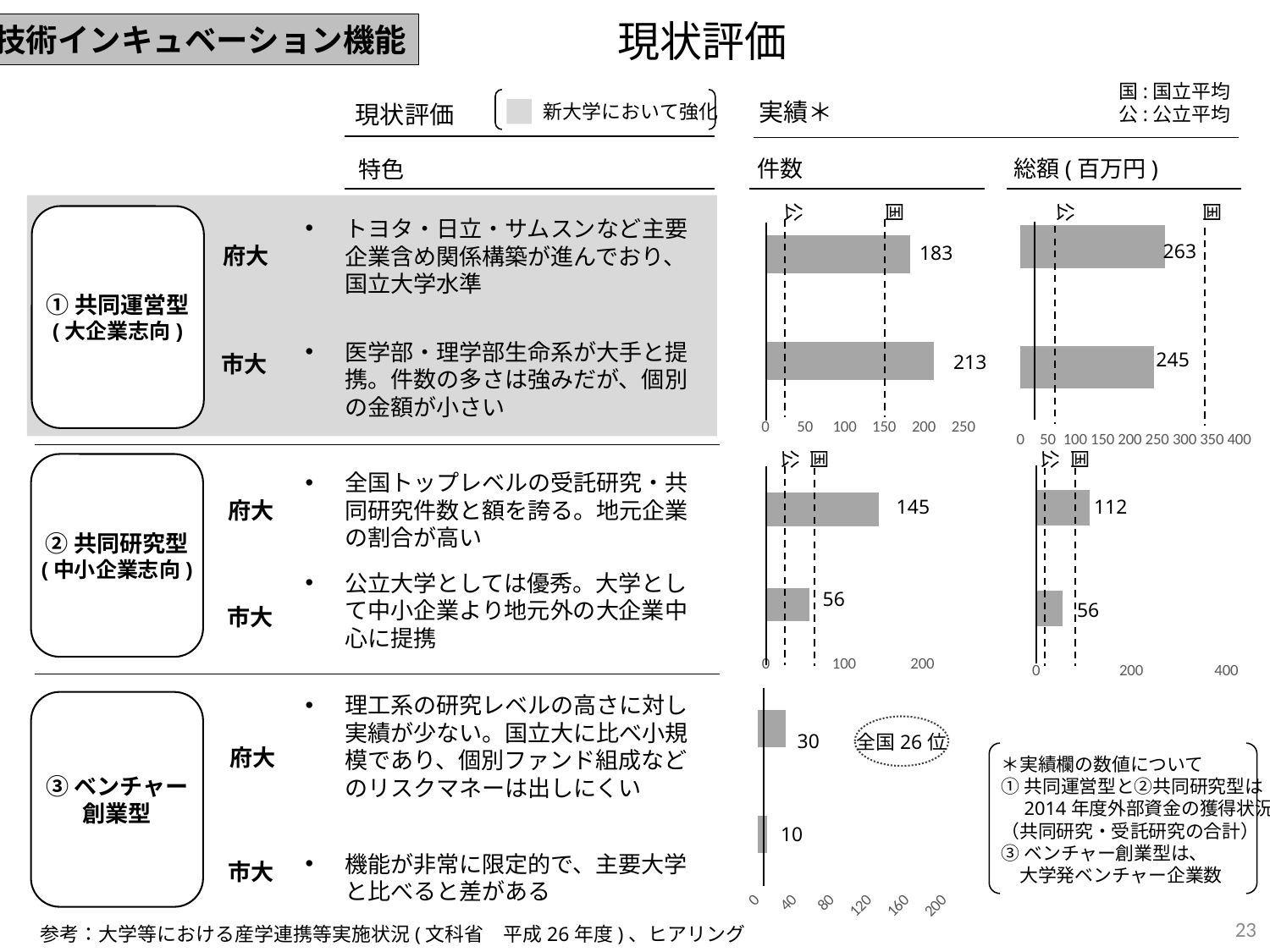
What type of chart is used in the 実績 section of the slide? bar chart In the ③ベンチャー創業型 件数 chart, what is the value for 府大? 30 In the ②共同研究型 件数 chart, which university has the higher value, 府大 or 市大? 府大 In the ②共同研究型 総額(百万円) chart, what is the value for 市大? 56 In the ①共同運営型 総額(百万円) chart, what is the difference between 府大 and 市大? 18 In the ①共同運営型 件数 chart, what is the value for 市大? 213 In the ①共同運営型 総額(百万円) chart, what is the value for 府大? 263 In the ②共同研究型 件数 chart, what is the difference between 府大 and 市大? 89 In the ③ベンチャー創業型 件数 chart, which university has the lowest value? 市大 In the ①共同運営型 件数 chart, what is the value for 府大? 183 In the ①共同運営型 件数 chart, is the value for 市大 greater or less than 200? greater In the ②共同研究型 総額(百万円) chart, what is the value for 府大? 112